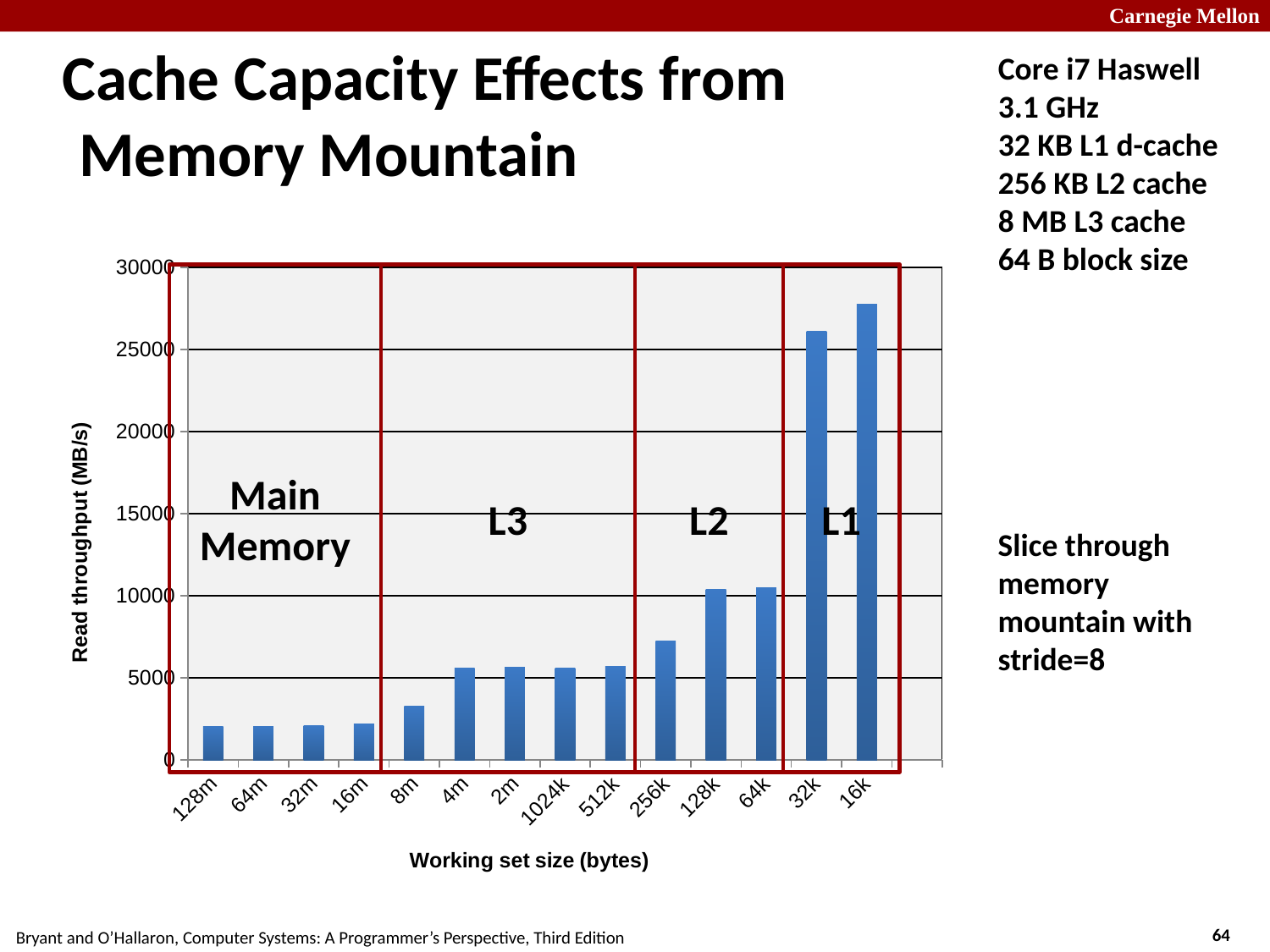
Do the read throughput values generally rise or fall moving from left to right along the x axis? rise Which has the higher read throughput, a working set size of 32k or 64k? 32k Is the read throughput for a working set size of 16k greater or less than 25000? greater Which has the higher read throughput, a working set size of 256k or 512k? 256k Which working set size has the highest read throughput? 16k What is the label of the y axis? Read throughput (MB/s) How many working set sizes are plotted along the x axis? 14 Is the read throughput for a working set size of 256k greater or less than 10000? less Which cache level label is placed over the two rightmost bars? L1 Is the read throughput for a working set size of 8m greater or less than 5000? less What kind of chart is shown on the slide? bar chart